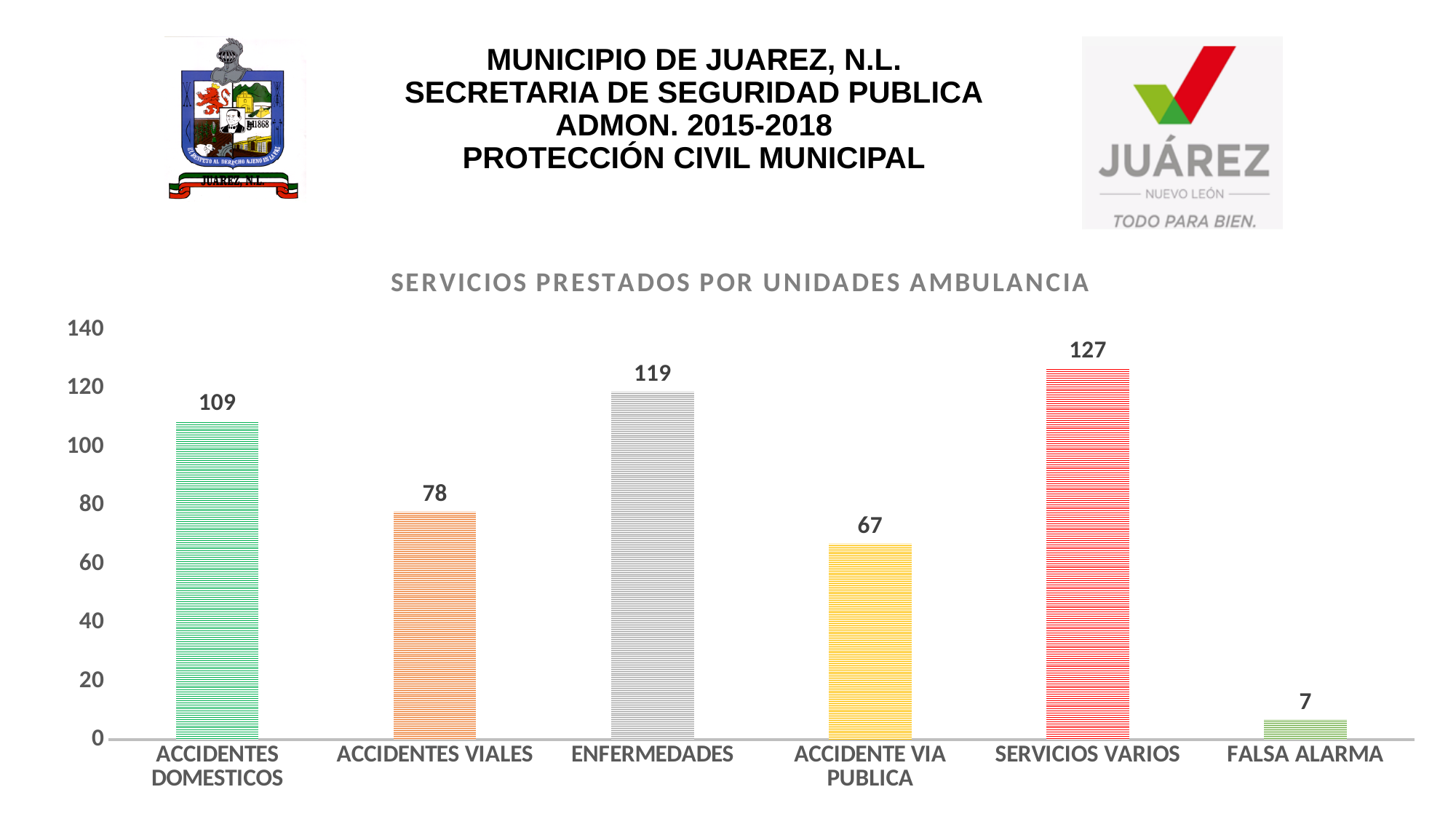
Is the value for ACCIDENTE VIA PUBLICA greater or less than 80? less Which category has the highest value? SERVICIOS VARIOS What is the value for ENFERMEDADES? 119 How many categories are shown in the chart? 6 What is the value for ACCIDENTES VIALES? 78 What is the title of the chart? SERVICIOS PRESTADOS POR UNIDADES AMBULANCIA What is the difference between SERVICIOS VARIOS and ACCIDENTES DOMESTICOS? 18 What is the difference between ENFERMEDADES and ACCIDENTE VIA PUBLICA? 52 What kind of chart is shown on the slide? bar chart Which category has the lowest value? FALSA ALARMA Which is larger, ACCIDENTES DOMESTICOS or ENFERMEDADES? ENFERMEDADES What is the value for FALSA ALARMA? 7